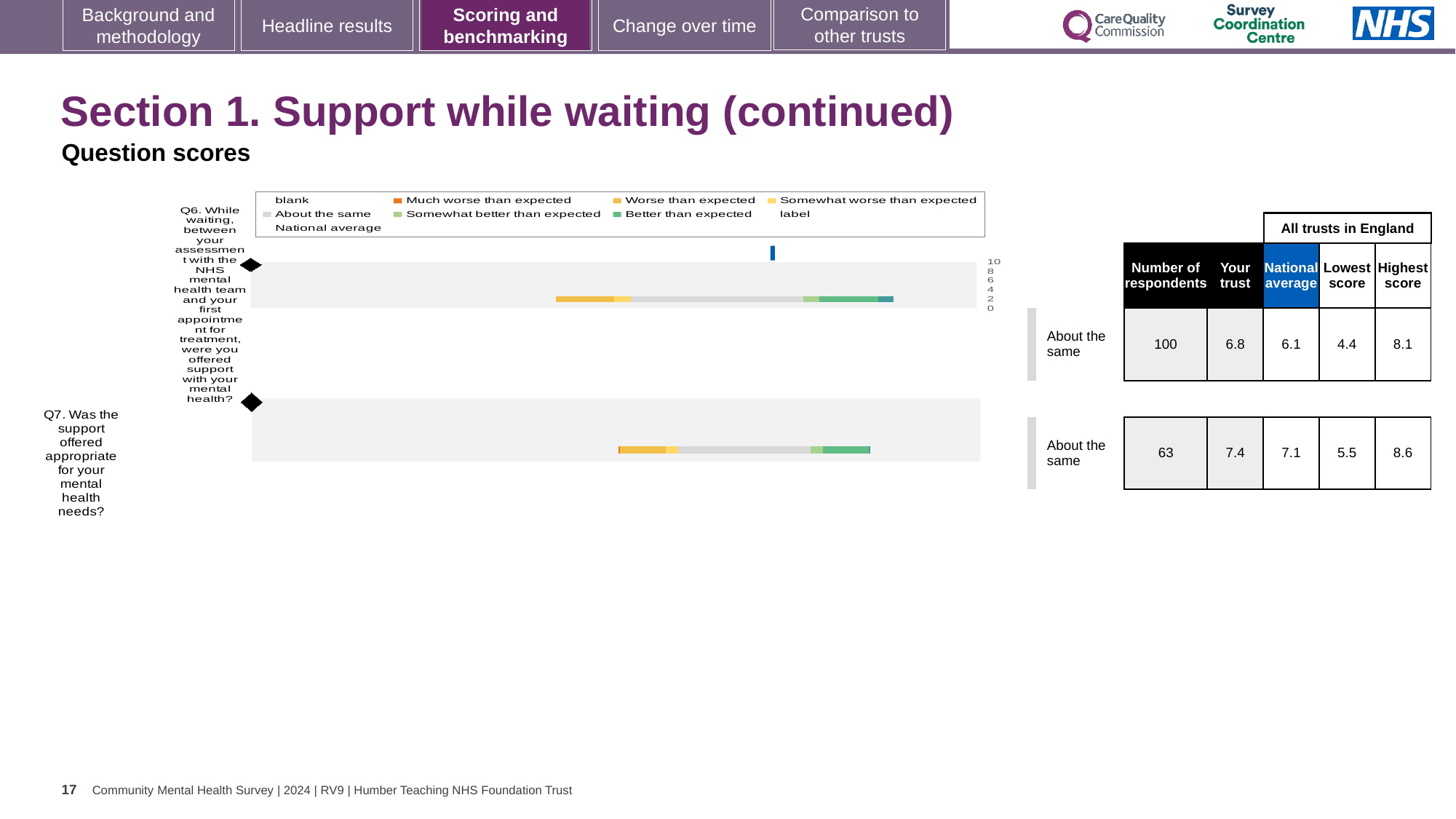
What is the 'Your trust' score for Q7 shown in the table beside the chart? 7.4 How many questions (categories) are plotted in the chart? 2 What is the 'Your trust' score for Q6 shown in the table beside the chart? 6.8 What colour does the legend use for 'Much worse than expected'? orange How many respondents answered Q7? 63 What is the national average for Q7? 7.1 What is the highest score among all trusts in England for Q7? 8.6 What is the lowest score among all trusts in England for Q6? 4.4 What colour does the legend use for 'Better than expected'? green What is the national average for Q6? 6.1 What kind of chart is shown on the slide? bar chart Which question has the higher 'Your trust' score, Q6 or Q7? Q7